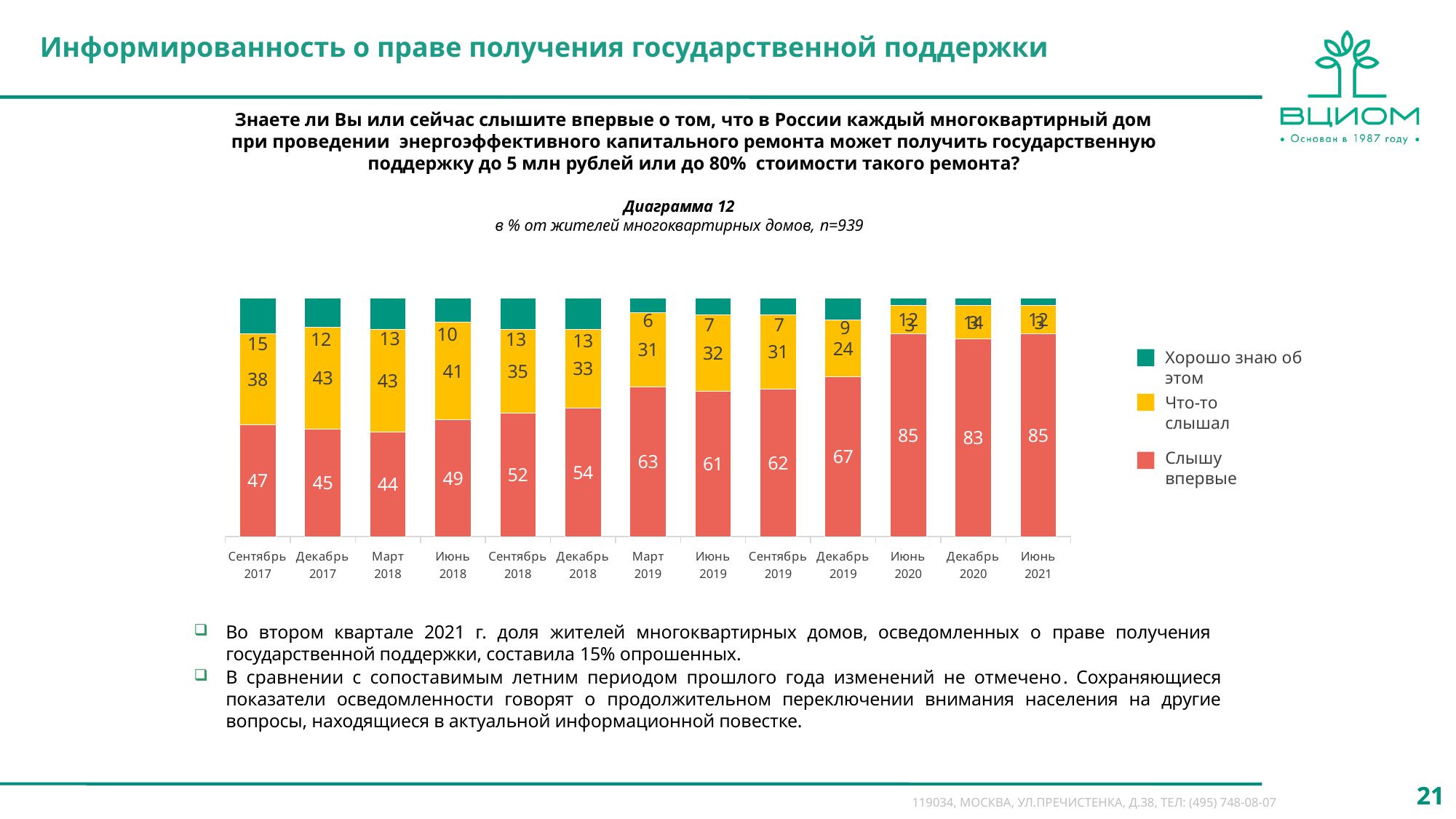
How many series does the legend list? 3 What is the total of the stacked bar for Сентябрь 2017? 100 What is the value for "Хорошо знаю об этом" in Июнь 2018? 10 Does the value for "Слышу впервые" generally rise or fall from Сентябрь 2017 to Июнь 2021? Rise How many time periods are shown on the x axis? 13 Which has the larger "Слышу впервые" value: Март 2019 or Июнь 2019? Март 2019 What is the value for "Что-то слышал" in Декабрь 2017? 43 What is the value for "Слышу впервые" in Сентябрь 2017? 47 What is the value for "Хорошо знаю об этом" in Март 2019? 6 In which period is the value for "Слышу впервые" the lowest? Март 2018 What is the difference between the "Слышу впервые" values for Декабрь 2019 and Сентябрь 2019? 5 What kind of chart is shown on the slide? Stacked bar chart